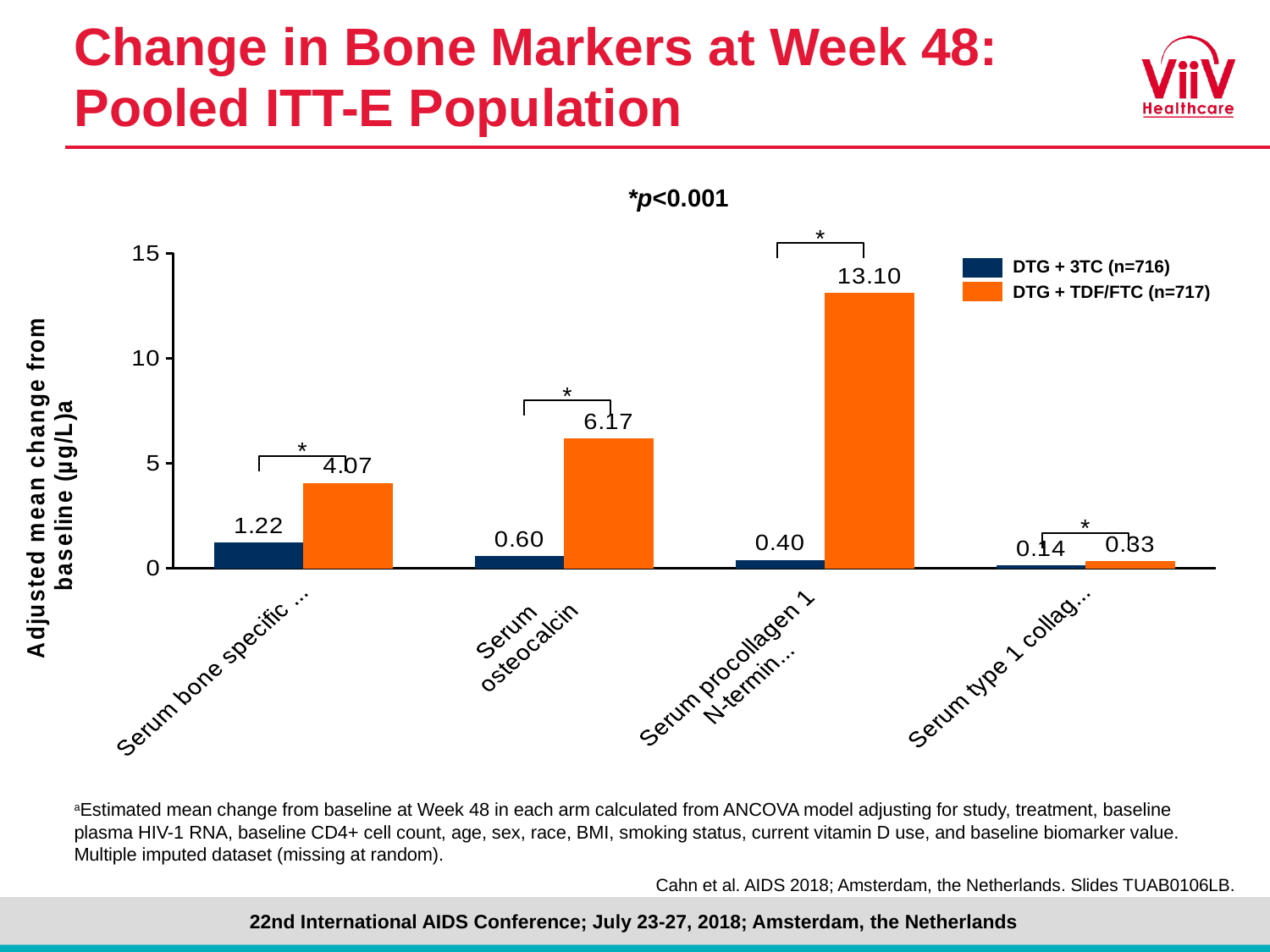
What colour are the bars for the DTG + TDF/FTC (n=717) series? Orange What is the adjusted mean change from baseline for Serum osteocalcin in the DTG + 3TC (n=716) arm? 0.60 What type of chart is shown on the slide? Bar chart What is the difference between the DTG + TDF/FTC (n=717) and DTG + 3TC (n=716) values for Serum osteocalcin? 5.57 Which category has the highest value for the DTG + TDF/FTC (n=717) series? Serum procollagen 1 N-termin... (third category) How many series does the legend list? 2 How many bone marker categories are shown on the x axis? 4 Is the DTG + TDF/FTC (n=717) value for the third category (Serum procollagen 1 ...) greater or less than 10? greater For Serum osteocalcin, which arm has the larger adjusted mean change: DTG + 3TC (n=716) or DTG + TDF/FTC (n=717)? DTG + TDF/FTC (n=717) Which category has the lowest value for the DTG + 3TC (n=716) series? Serum type 1 collag... (fourth category) What is the adjusted mean change from baseline for Serum osteocalcin in the DTG + TDF/FTC (n=717) arm? 6.17 What is the value of the DTG + TDF/FTC (n=717) bar for the third category (Serum procollagen 1 ...)? 13.10